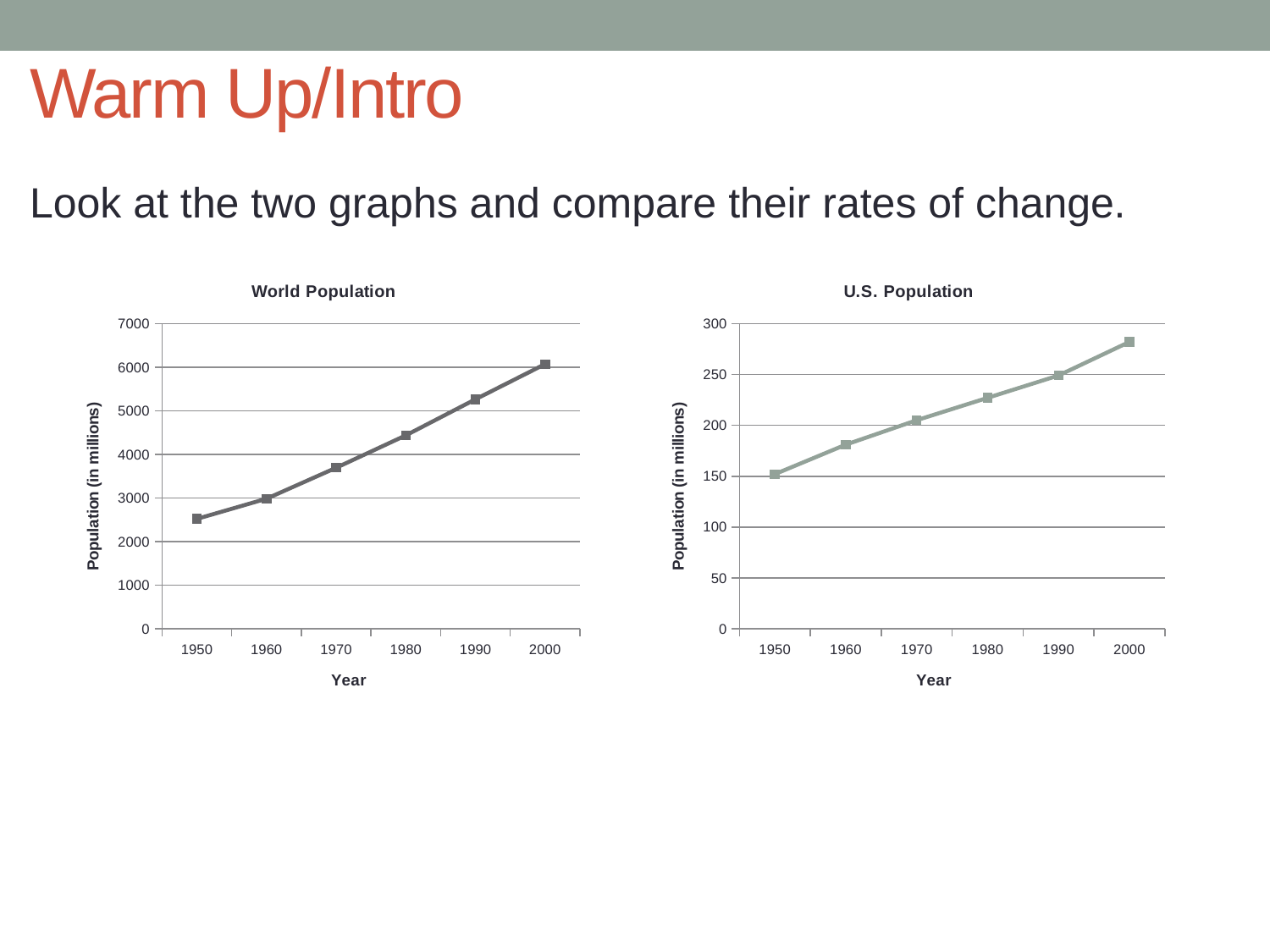
In the World Population chart, is the value for 1950 greater or less than 3000? less In the U.S. Population chart, which year has the lowest population? 1950 How many data points are plotted in the World Population chart? 6 In the U.S. Population chart, is the value for 1950 greater or less than 200? less What is the y-axis label of the U.S. Population chart? Population (in millions) In the U.S. Population chart, is the value for 2000 greater or less than 250? greater In the World Population chart, which year has the highest population? 2000 What type of chart is the World Population chart? line chart In the World Population chart, which year has the lowest population? 1950 In the U.S. Population chart, do the values rise or fall from 1950 to 2000? rise